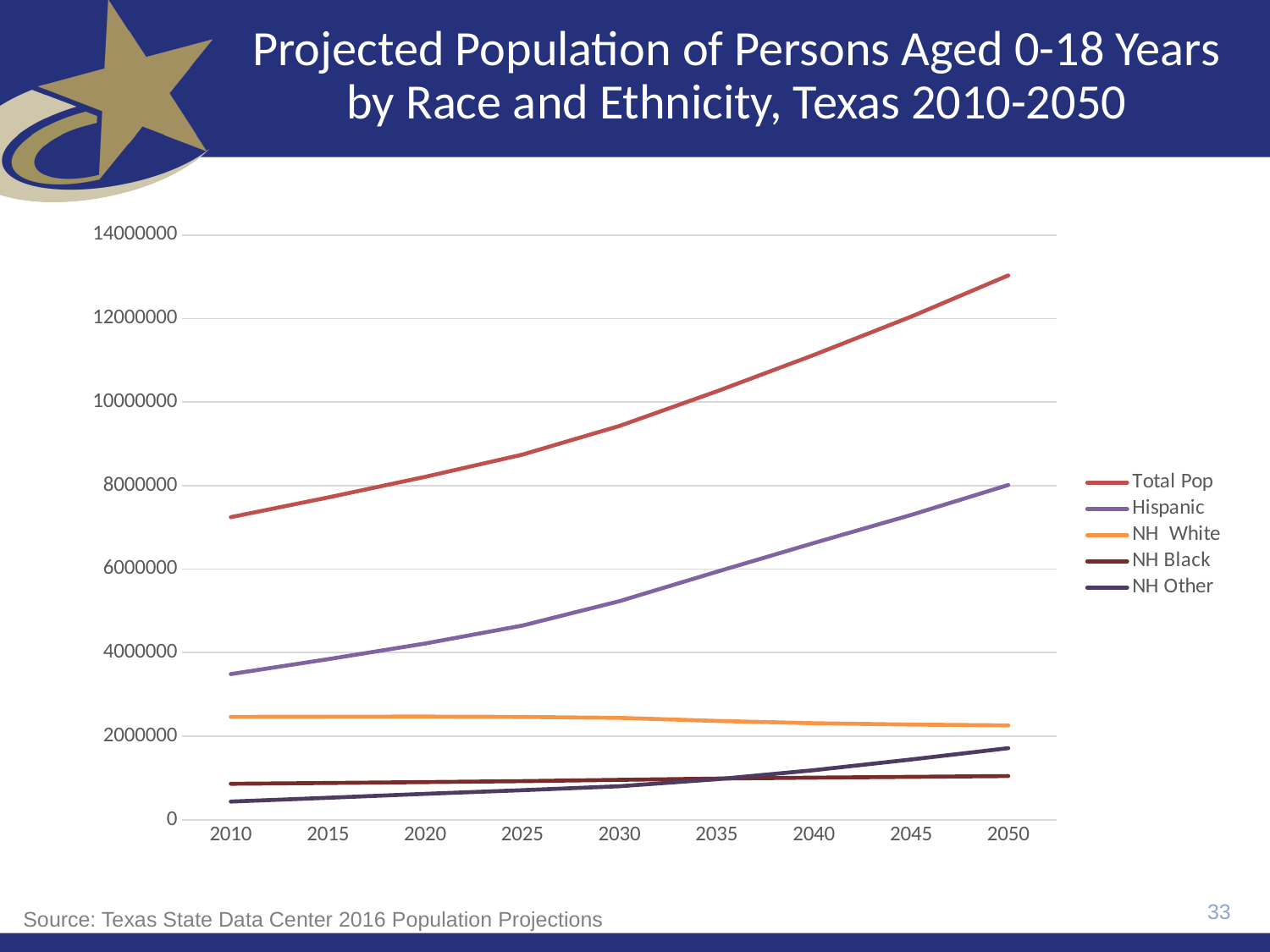
Does the NH White line rise or fall from 2010 to 2050? fall Which series has the lowest value in 2010? NH Other What kind of chart is shown on the slide? line chart Which series has the highest value in 2050? Total Pop Is the value for Total Pop in 2050 greater or less than 12000000? greater How many years are marked along the x axis? 9 Is the value for Hispanic in 2010 greater or less than 4000000? less Does the Total Pop line rise or fall from 2010 to 2050? rise In 2010, which is larger: NH Black or NH Other? NH Black What is the title of the chart on the slide? Projected Population of Persons Aged 0-18 Years by Race and Ethnicity, Texas 2010-2050 How many series does the legend list? 5 In 2050, which is larger: NH Other or NH Black? NH Other